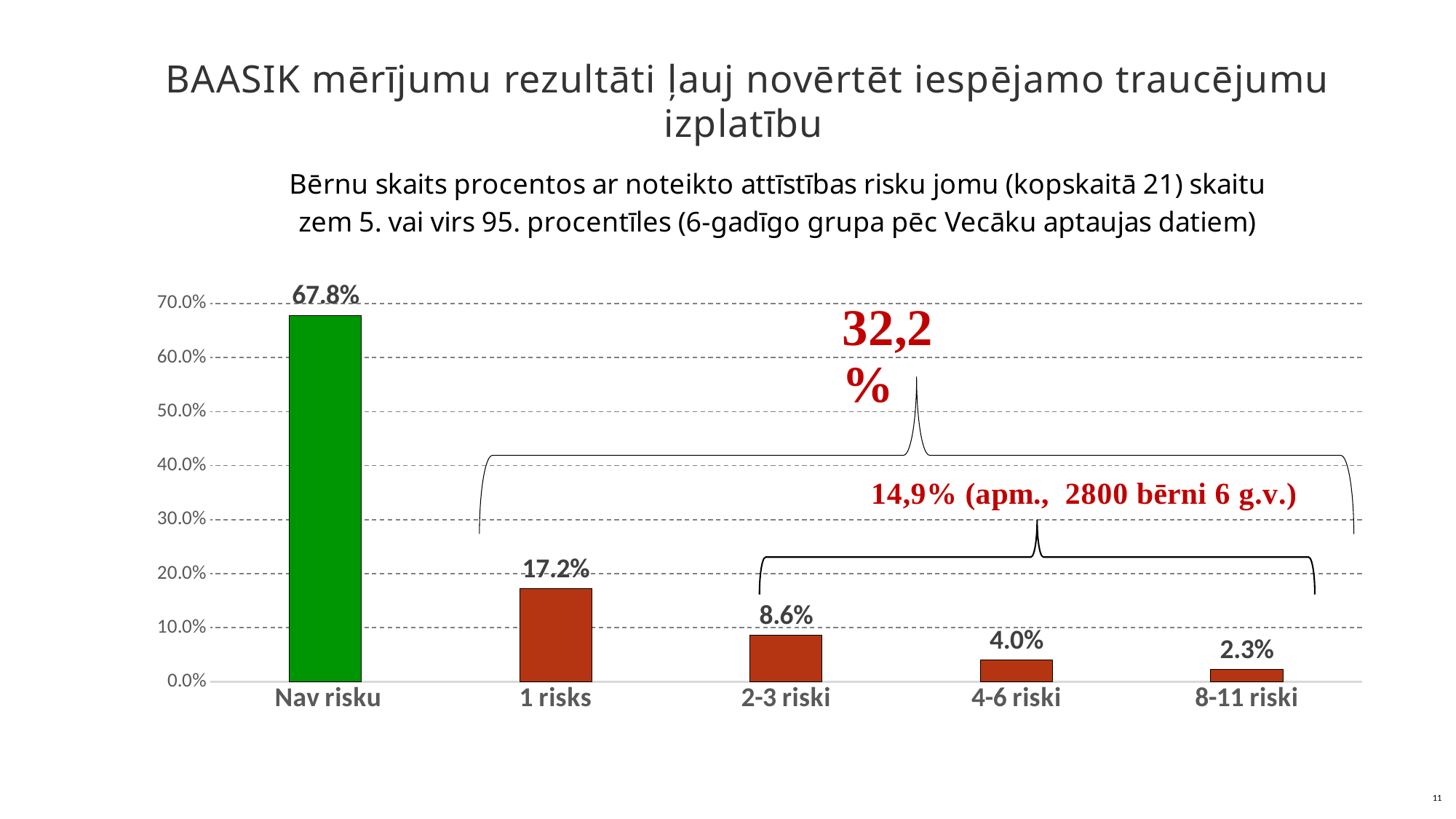
What kind of chart is this? Bar chart Do the values rise or fall from left to right along the x axis? Fall What is the value for "2-3 riski"? 8.6% What colour is the bar for "Nav risku"? Green How many categories are shown on the x axis? 5 Which category has the lowest value? 8-11 riski What is the value for "Nav risku"? 67.8% What is the value for "1 risks"? 17.2% Which category has the highest value? Nav risku Which is larger, the value for "4-6 riski" or the value for "8-11 riski"? 4-6 riski What is the difference between the values for "1 risks" and "2-3 riski"? 8.6% What is the value for "8-11 riski"? 2.3%